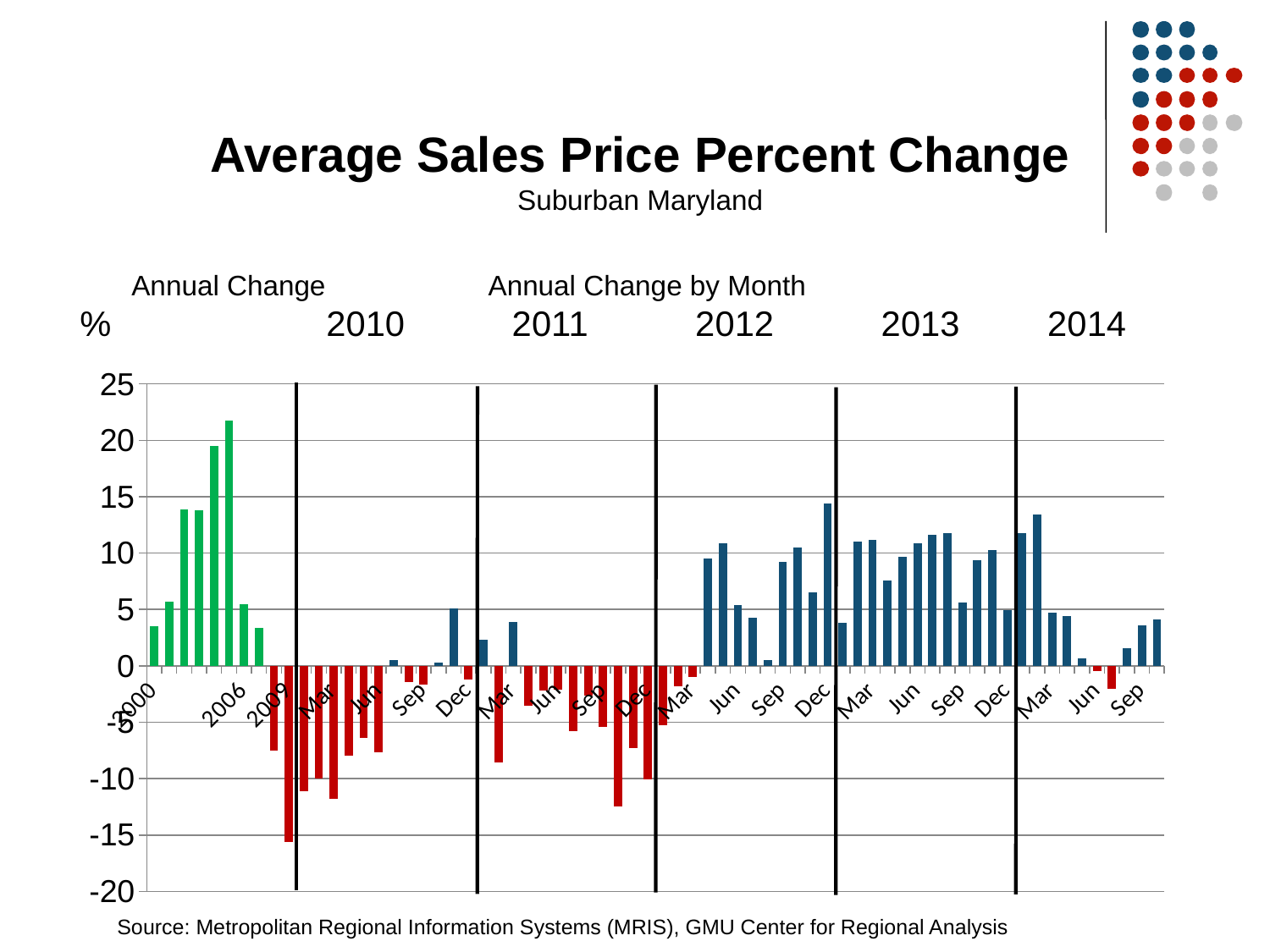
Is the annual change value for 2000 greater or less than 5? less What region does the subtitle say the chart covers? Suburban Maryland Which is larger, the value for Dec 2012 or the value for Dec 2011? Dec 2012 Is the value for Jun 2011 greater or less than 0? less Across the months of 2012, do the values generally rise or fall from January to December? rise What kind of chart is shown on the slide? bar chart Is the value for Dec 2011 greater or less than -5? less Is the lowest bar in the chart in the 'Annual Change' section or the 'Annual Change by Month' section? Annual Change Which is larger, the value for Mar 2013 or the value for Mar 2011? Mar 2013 How many years are labelled in the 'Annual Change by Month' section of the chart? 5